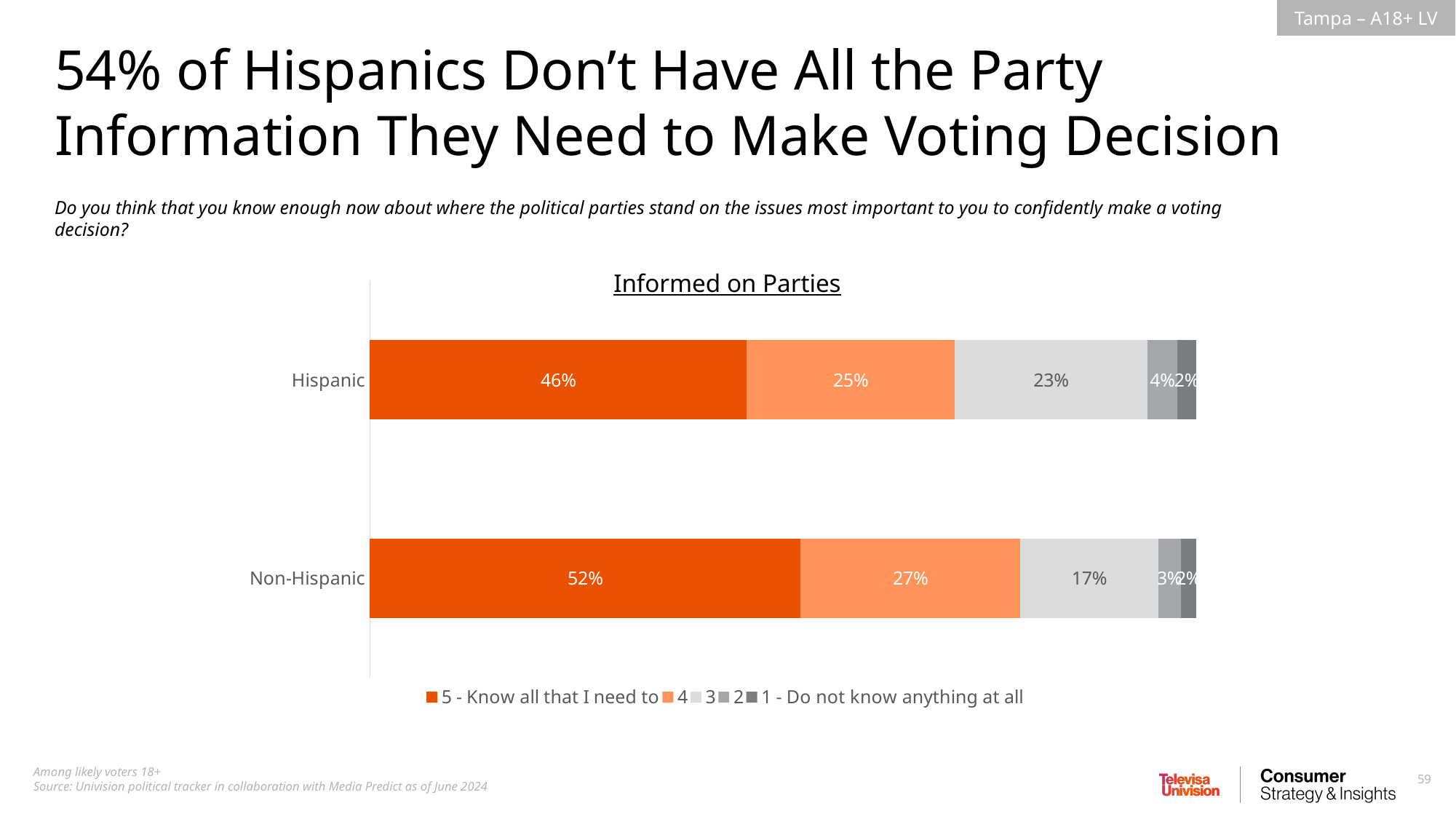
What percentage of Hispanic respondents answered "5 - Know all that I need to"? 46% Which response segment is the largest in the Hispanic bar? 5 - Know all that I need to How many groups (categories) are shown in the chart? 2 How many percentage points higher is the Non-Hispanic "5 - Know all that I need to" share than the Hispanic share? 6 percentage points What kind of chart is shown on the slide? Stacked bar chart Which group has the larger share answering "5 - Know all that I need to", Hispanic or Non-Hispanic? Non-Hispanic What is the value of the "4" segment for the Hispanic bar? 25% How many series does the legend list? 5 How many percentage points higher is the Hispanic "3" share than the Non-Hispanic "3" share? 6 percentage points What percentage of Non-Hispanic respondents answered "5 - Know all that I need to"? 52% What is the value of the "3" segment for the Non-Hispanic bar? 17% What is the value of the "3" segment for the Hispanic bar? 23%